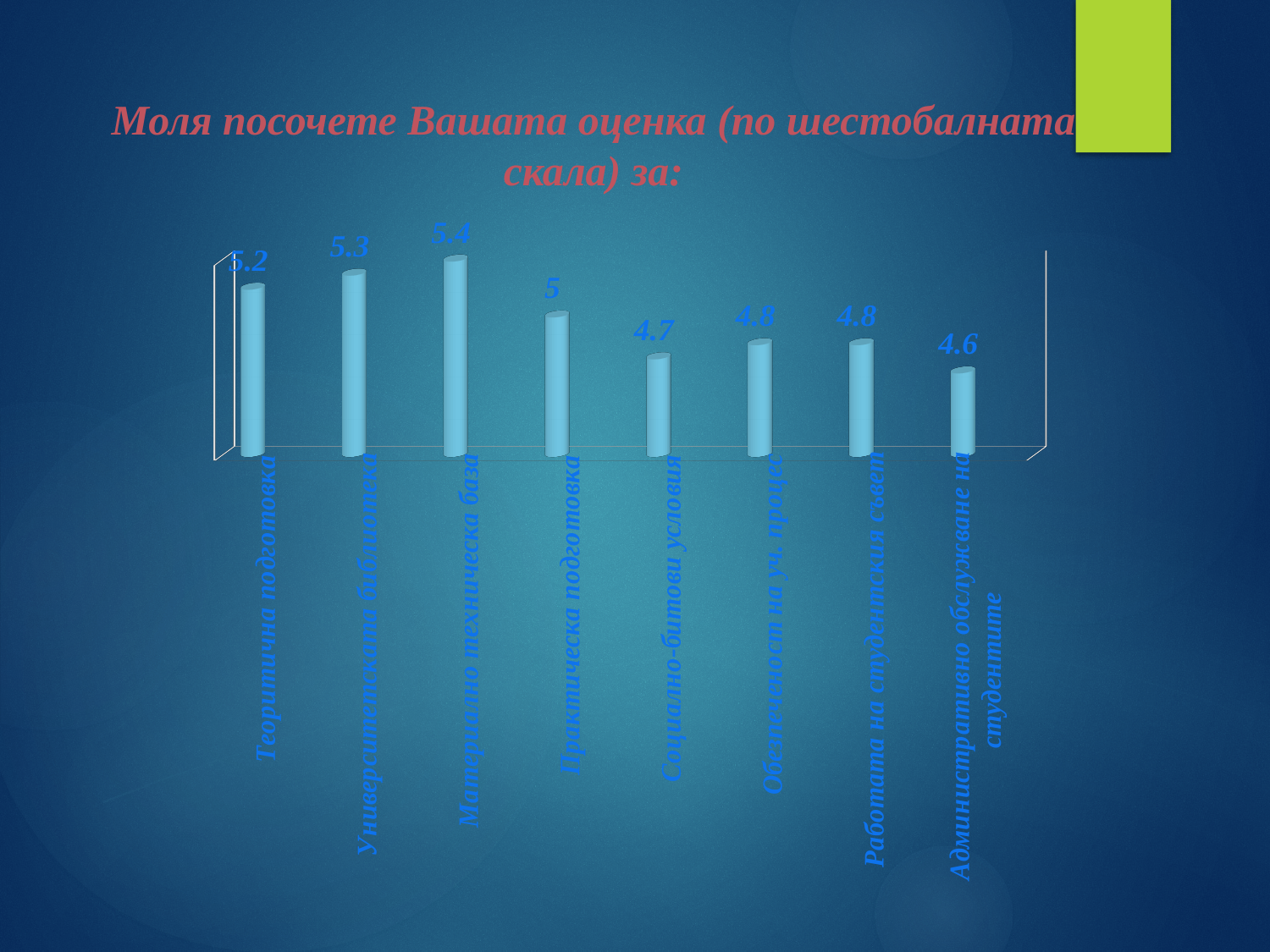
What is the value for Материално техническа база? 5.4 What is the difference between the values for Материално техническа база and Административно обслужване на студентите? 0.8 What is the value for Практическа подготовка? 5 What is the title of the chart on the slide? Моля посочете Вашата оценка (по шестобалната скала) за: How many categories are shown in the chart? 8 Which is larger, the value for Университетската библиотека or the value for Практическа подготовка? Университетската библиотека What kind of chart is shown on the slide? Bar chart Which category has the lowest value? Административно обслужване на студентите What is the value for Административно обслужване на студентите? 4.6 What is the value for Социално-битови условия? 4.7 What is the value for Теоритична подготовка? 5.2 Which category has the highest value? Материално техническа база